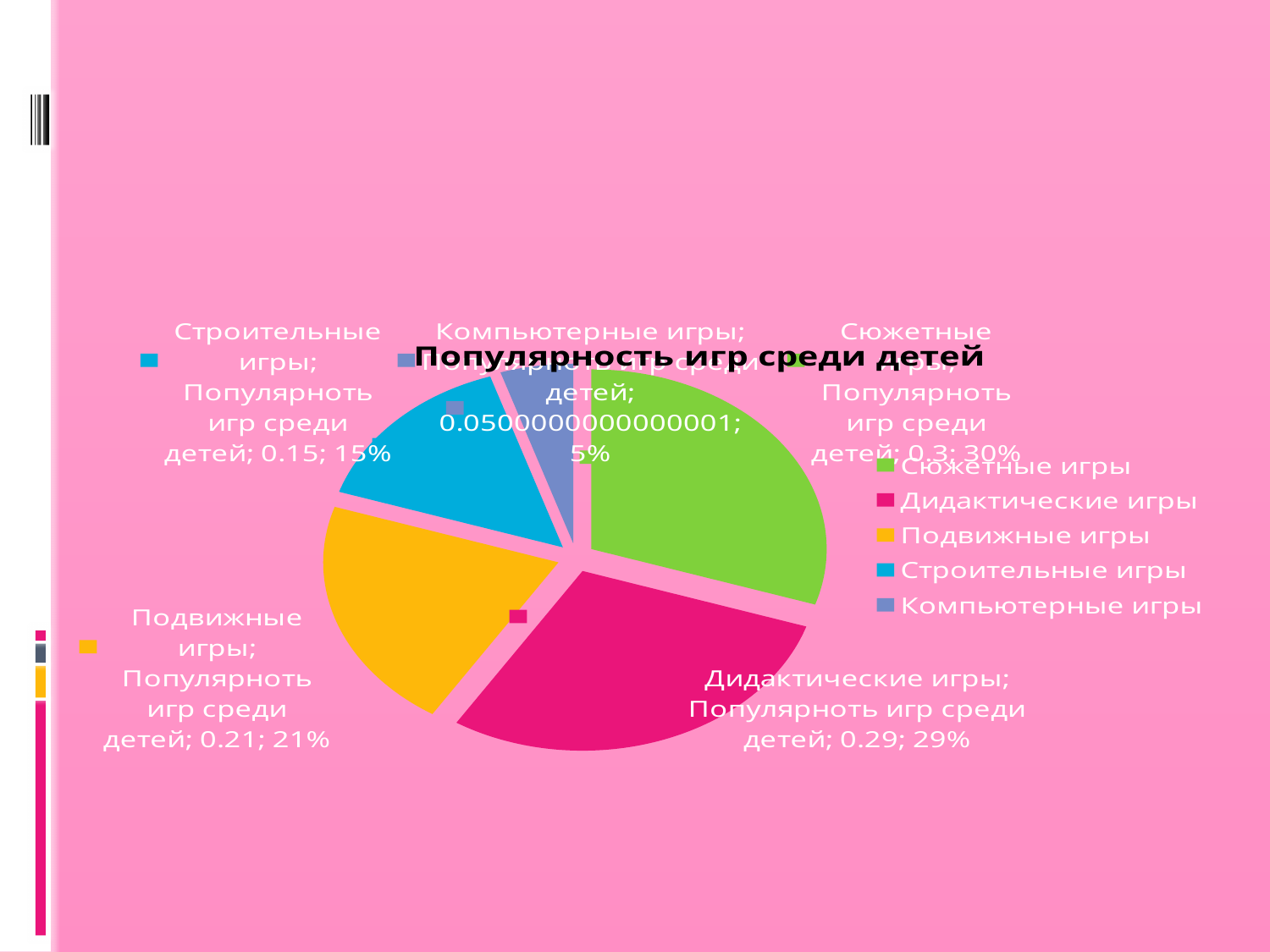
Which category has the largest slice of the pie? Сюжетные игры Which category has the smallest slice of the pie? Компьютерные игры What is the title of the chart? Популярность игр среди детей How many slices does the pie chart have? 5 What percentage share does the slice for Компьютерные игры have? 5% What is the difference in percentage points between the shares of Подвижные игры and Строительные игры? 6% What kind of chart is shown on the slide? pie chart What percentage share does the slice for Строительные игры have? 15% Which slice is larger: Подвижные игры or Компьютерные игры? Подвижные игры What percentage share does the slice for Подвижные игры have? 21%